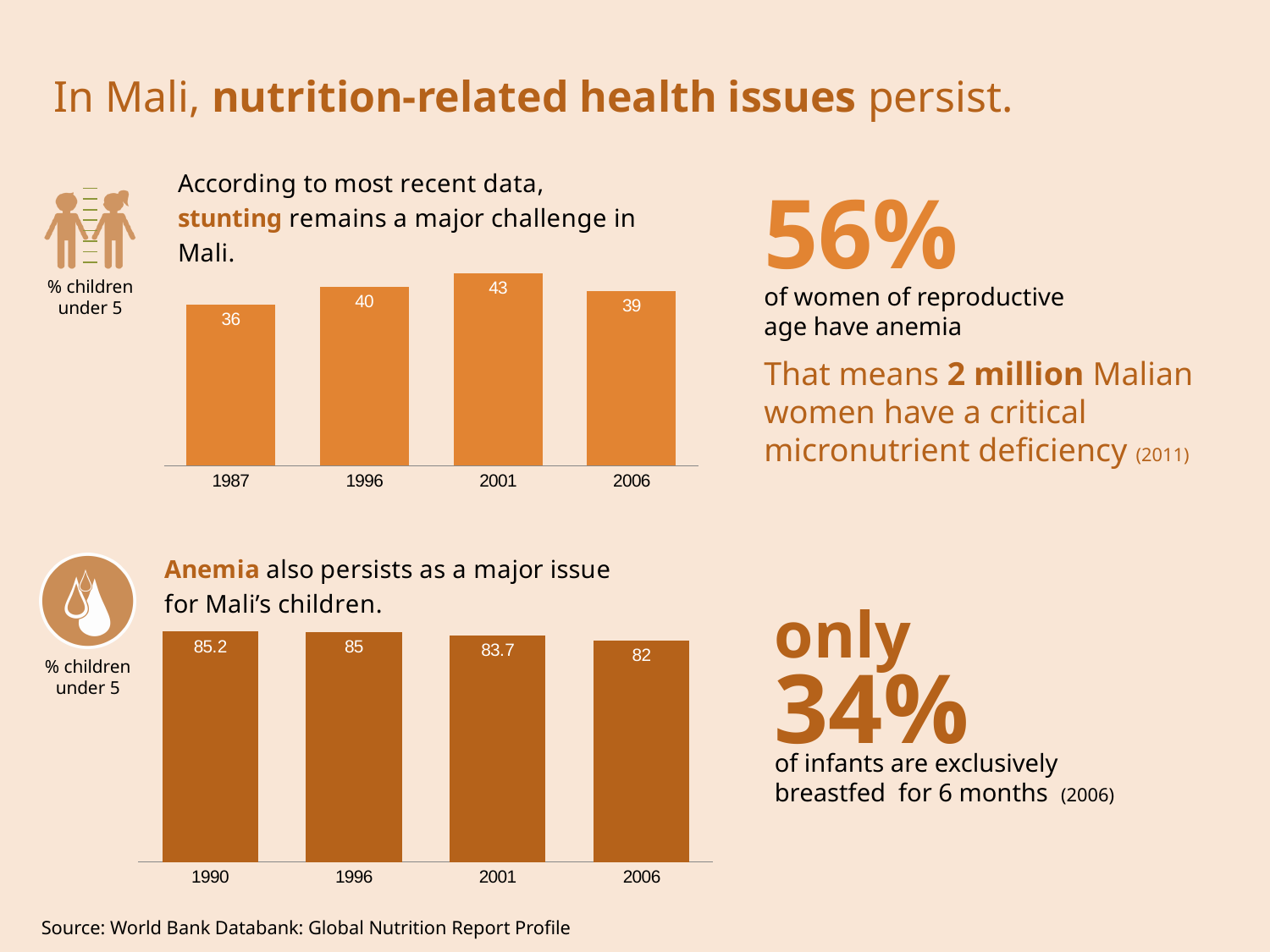
What kind of chart is the anemia chart (bottom)? bar chart In the stunting chart (top), what is the difference between the 2001 and 1987 values? 7 In the anemia chart (bottom), what is the difference between the 1990 and 2006 values? 3.2 In the stunting chart (top), is the value for 1996 larger or smaller than the value for 2006? larger In the stunting chart (top), how many years are plotted? 4 In the anemia chart (bottom), which year has the lowest value? 2006 In the stunting chart (top), what is the value for 2001? 43 In the stunting chart (top), which year has the lowest value? 1987 In the stunting chart (top), which year has the highest value? 2001 In the anemia chart (bottom), what is the value for 2006? 82 In the anemia chart (bottom), what is the value for 1990? 85.2 In the anemia chart (bottom), do the values rise or fall from 1990 to 2006? fall